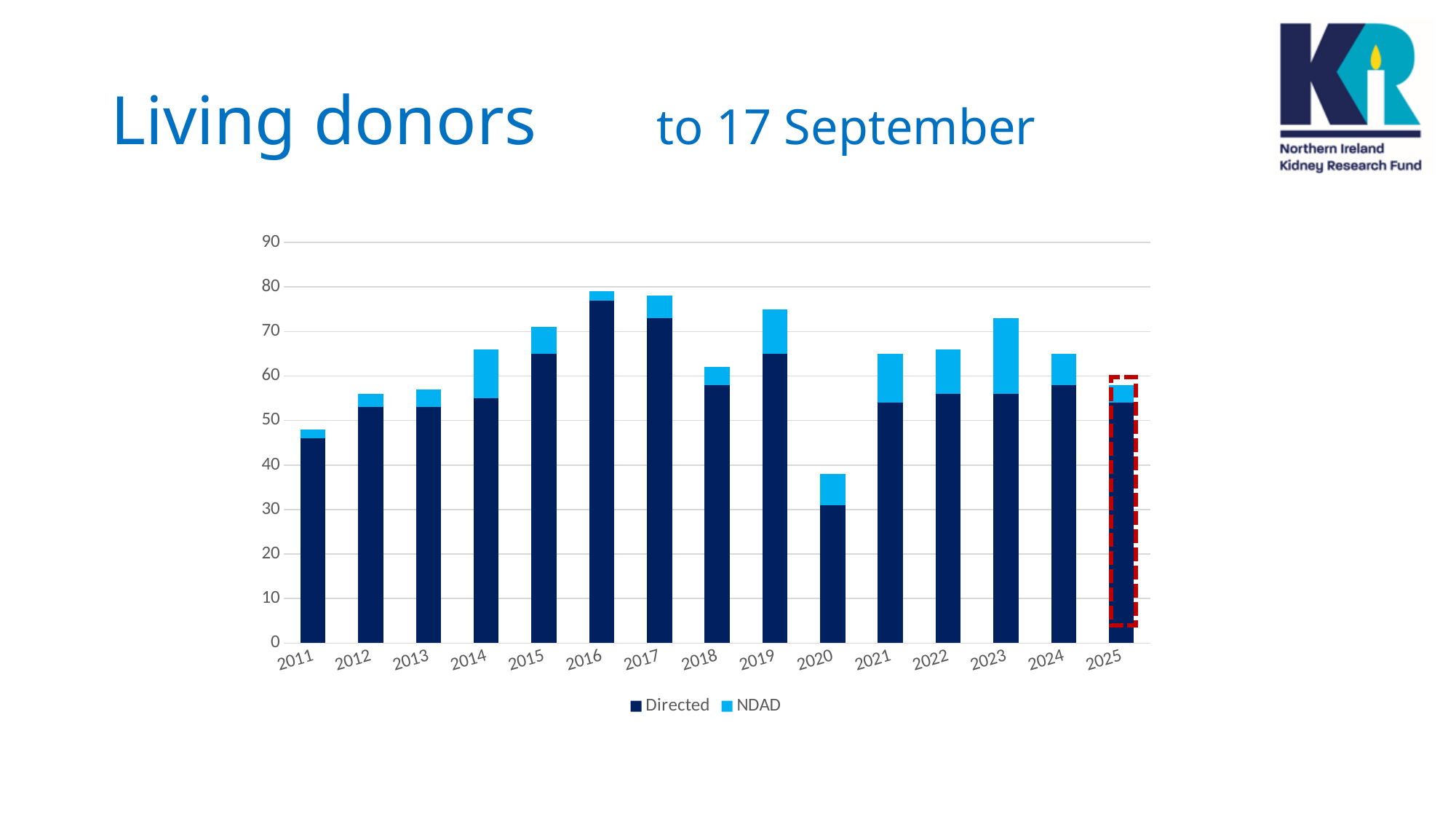
How many years are shown on the x axis? 15 Which year has the highest Directed value? 2016 Is the total value for 2020 greater or less than 40? less What kind of chart is shown on the slide? bar chart Is the total value for 2016 greater or less than 70? greater Which year has the larger total, 2023 or 2024? 2023 Is the total value for 2011 greater or less than 50? less Which year has the lowest total number of living donors? 2020 Do the total values rise or fall from 2011 to 2016? rise How many series does the legend list? 2 Which year's bar is outlined with a red dashed box? 2025